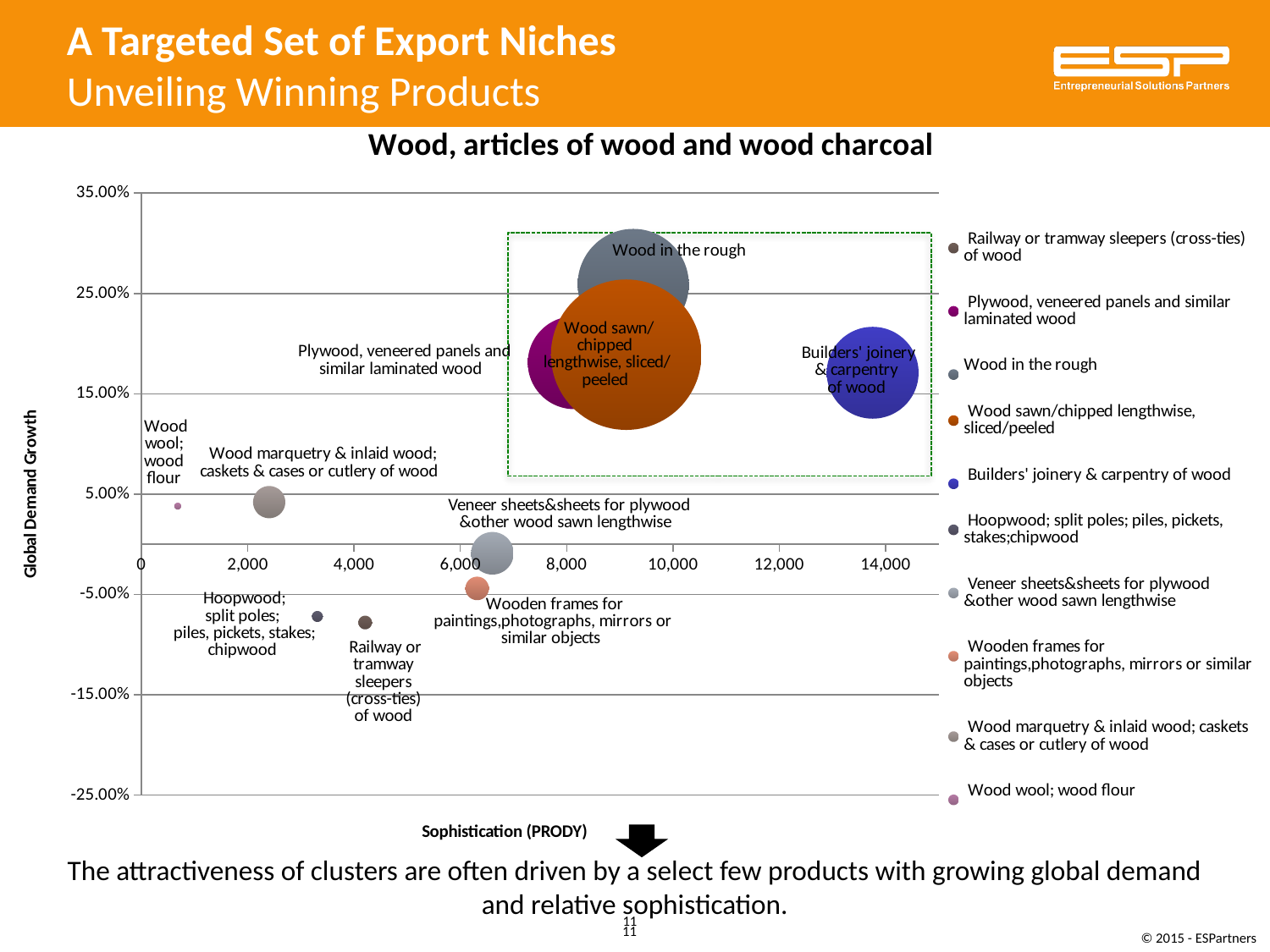
What is the label of the vertical axis? Global Demand Growth Is the sophistication (PRODY) value for Builders' joinery & carpentry of wood greater or less than 12,000? greater Is the sophistication (PRODY) value for Hoopwood; split poles; piles, pickets, stakes; chipwood greater or less than 4,000? less How many products does the chart legend list? 10 Which has the higher global demand growth, Wood in the rough or Builders' joinery & carpentry of wood? Wood in the rough Is the global demand growth for Railway or tramway sleepers (cross-ties) of wood greater or less than -5.00%? less Which product has the highest global demand growth? Wood in the rough What is the title of the chart? Wood, articles of wood and wood charcoal What kind of chart is shown on the slide? Bubble chart Which product has the highest sophistication (PRODY) value? Builders' joinery & carpentry of wood Which product has the lowest sophistication (PRODY) value? Wood wool; wood flour